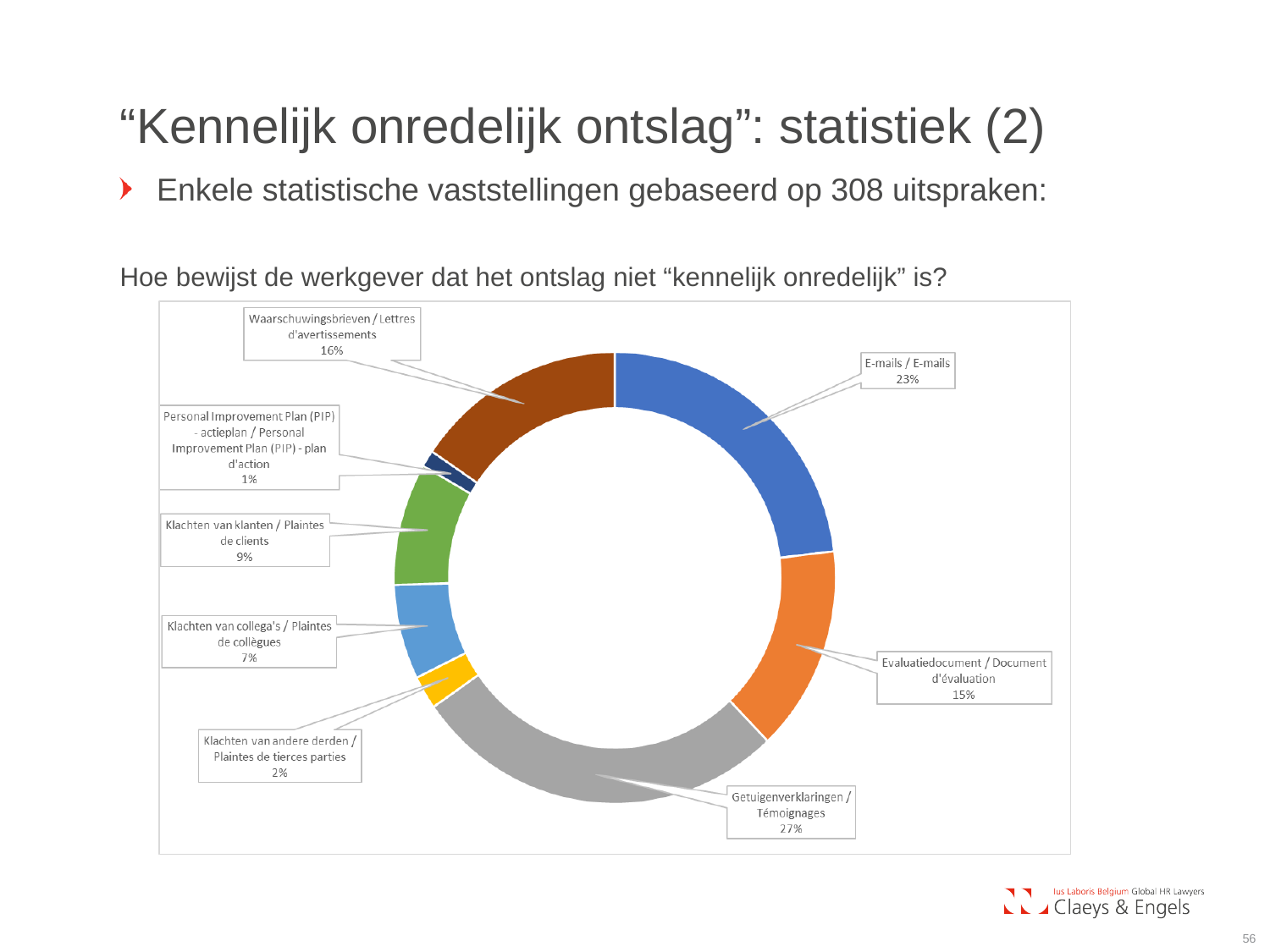
What is the combined share of Klachten van collega's / Plaintes de collègues and Klachten van andere derden / Plaintes de tierces parties? 9% Which category has the smallest share in the chart? Personal Improvement Plan (PIP) - actieplan / Personal Improvement Plan (PIP) - plan d'action What percentage is shown for Klachten van klanten / Plaintes de clients? 9% Which is larger: Waarschuwingsbrieven / Lettres d'avertissements or Evaluatiedocument / Document d'évaluation? Waarschuwingsbrieven / Lettres d'avertissements What kind of chart is shown on the slide? Doughnut (pie) chart What is the difference in percentage points between Getuigenverklaringen / Témoignages and E-mails / E-mails? 4 What percentage is shown for Evaluatiedocument / Document d'évaluation? 15% What colour is the segment for Getuigenverklaringen / Témoignages? Grey What percentage is shown for Getuigenverklaringen / Témoignages? 27% What share of the chart is labelled E-mails / E-mails? 23% Which category has the largest share in the chart? Getuigenverklaringen / Témoignages How many categories are shown in the chart? 8